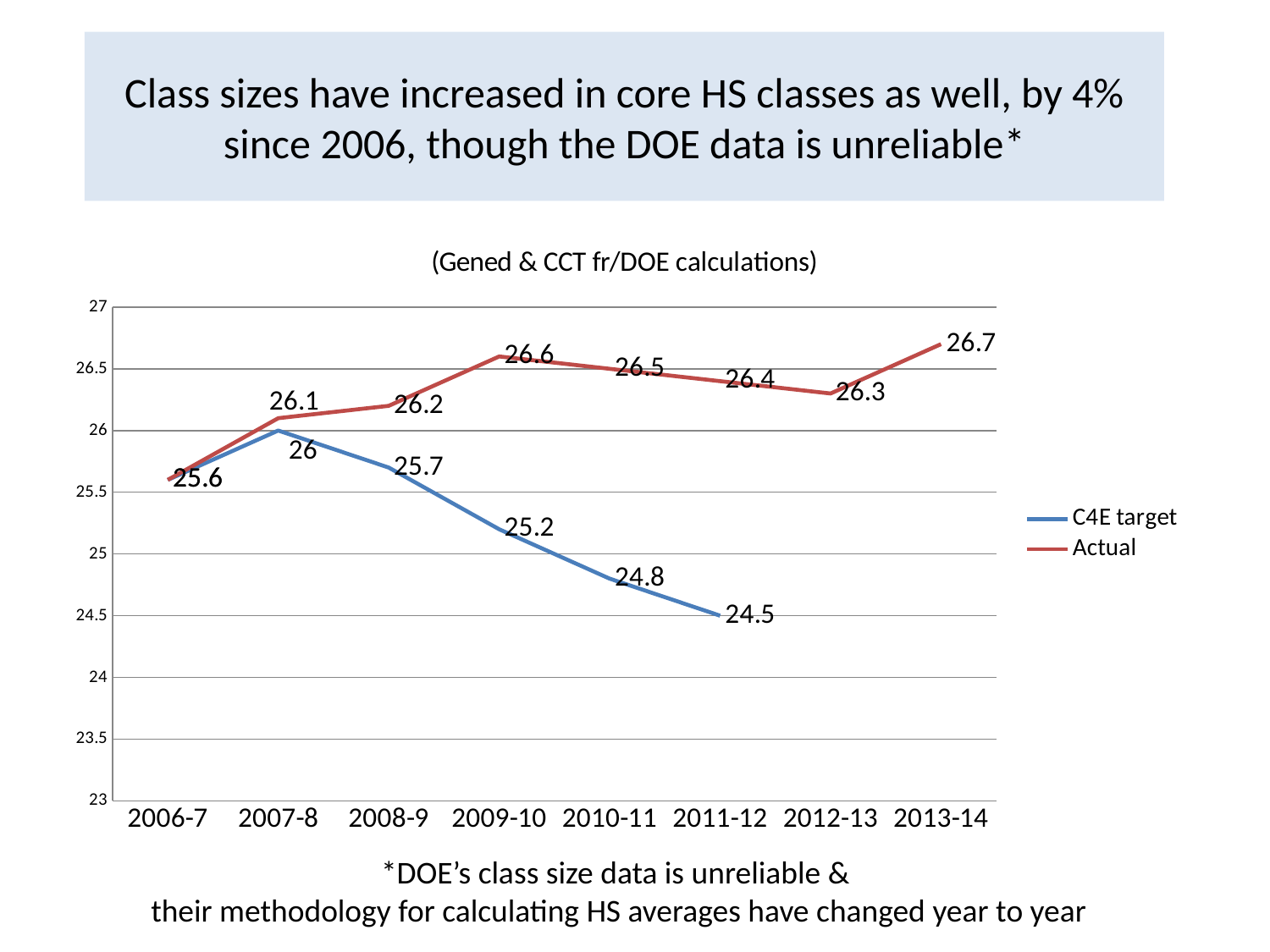
In which year is the C4E target value lowest? 2011-12 What is the difference between the Actual value and the C4E target value in 2011-12? 1.9 What is the Actual value for 2013-14? 26.7 What is the C4E target value for 2008-9? 25.7 What is the C4E target value for 2011-12? 24.5 Does the C4E target line rise or fall from 2007-8 to 2011-12? Fall Which is larger in 2010-11, the Actual value or the C4E target value? Actual How many series does the legend list? 2 In which year is the Actual value highest? 2013-14 What is the Actual value for 2009-10? 26.6 What kind of chart is shown on the slide? Line chart How many school years are shown on the x axis? 8